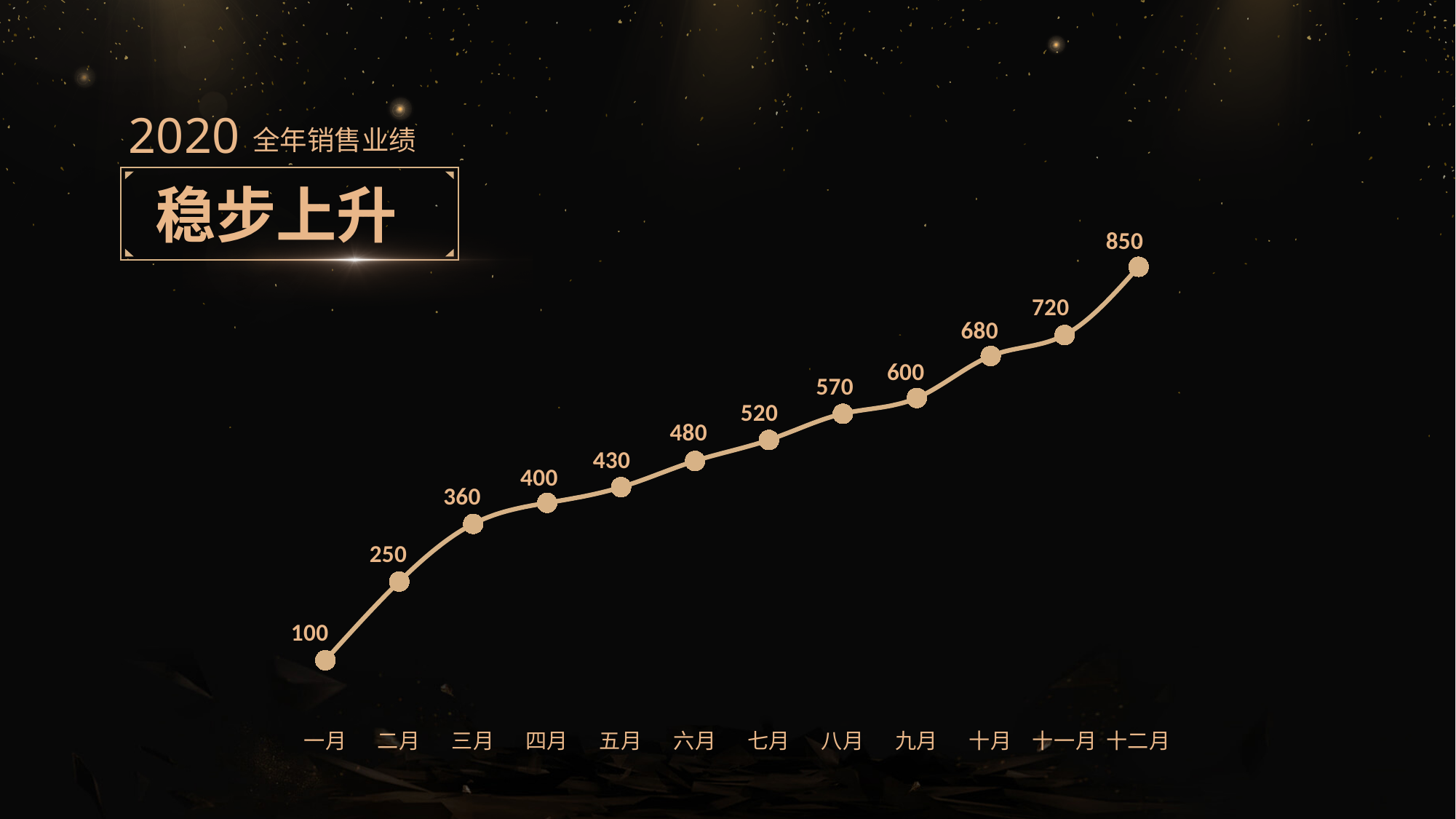
What is the difference between the values for 二月 and 三月? 110 Do the values rise or fall from 一月 to 十二月? rise What is the value for 八月? 570 Which month has the lowest value? 一月 Which is larger, the value for 六月 or the value for 九月? 九月 Which month has the highest value? 十二月 What is the difference between the values for 十二月 and 一月? 750 How many months are plotted on the chart? 12 What is the value for 十一月? 720 What kind of chart is shown on the slide? line chart What is the heading shown in the box above the chart? 稳步上升 What is the value for 三月? 360